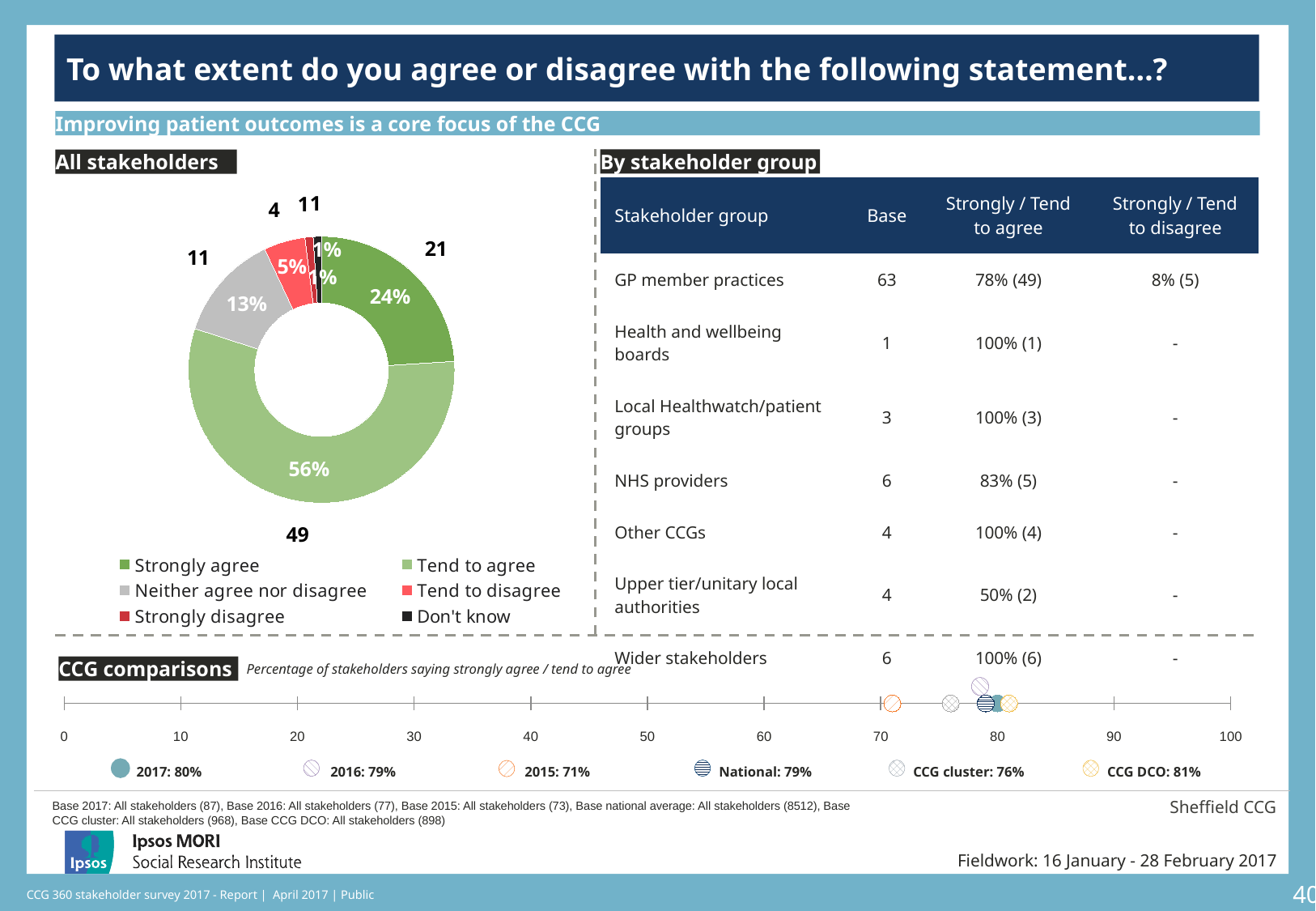
How many response categories does the legend of the All stakeholders chart list? 6 In the All stakeholders chart, what percentage of stakeholders said 'Tend to agree'? 56% In the All stakeholders chart, what percentage of stakeholders said 'Strongly agree'? 24% In the CCG comparisons chart, what is the 2017 percentage of stakeholders saying strongly agree / tend to agree? 80% In the All stakeholders chart, which is larger: 'Strongly agree' or 'Neither agree nor disagree'? Strongly agree In the All stakeholders chart, what is the difference in percentage points between 'Tend to agree' and 'Strongly agree'? 32 percentage points In the CCG comparisons chart, which comparison point has the lowest value? 2015: 71% In the All stakeholders chart, which response category has the largest share? Tend to agree In the All stakeholders chart, what percentage said 'Tend to disagree'? 5% In the All stakeholders chart, what percentage said 'Neither agree nor disagree'? 13% What type of chart is the All stakeholders chart? Donut (pie) chart In the CCG comparisons chart, what is the difference in percentage points between 2017 and 2015? 9 percentage points